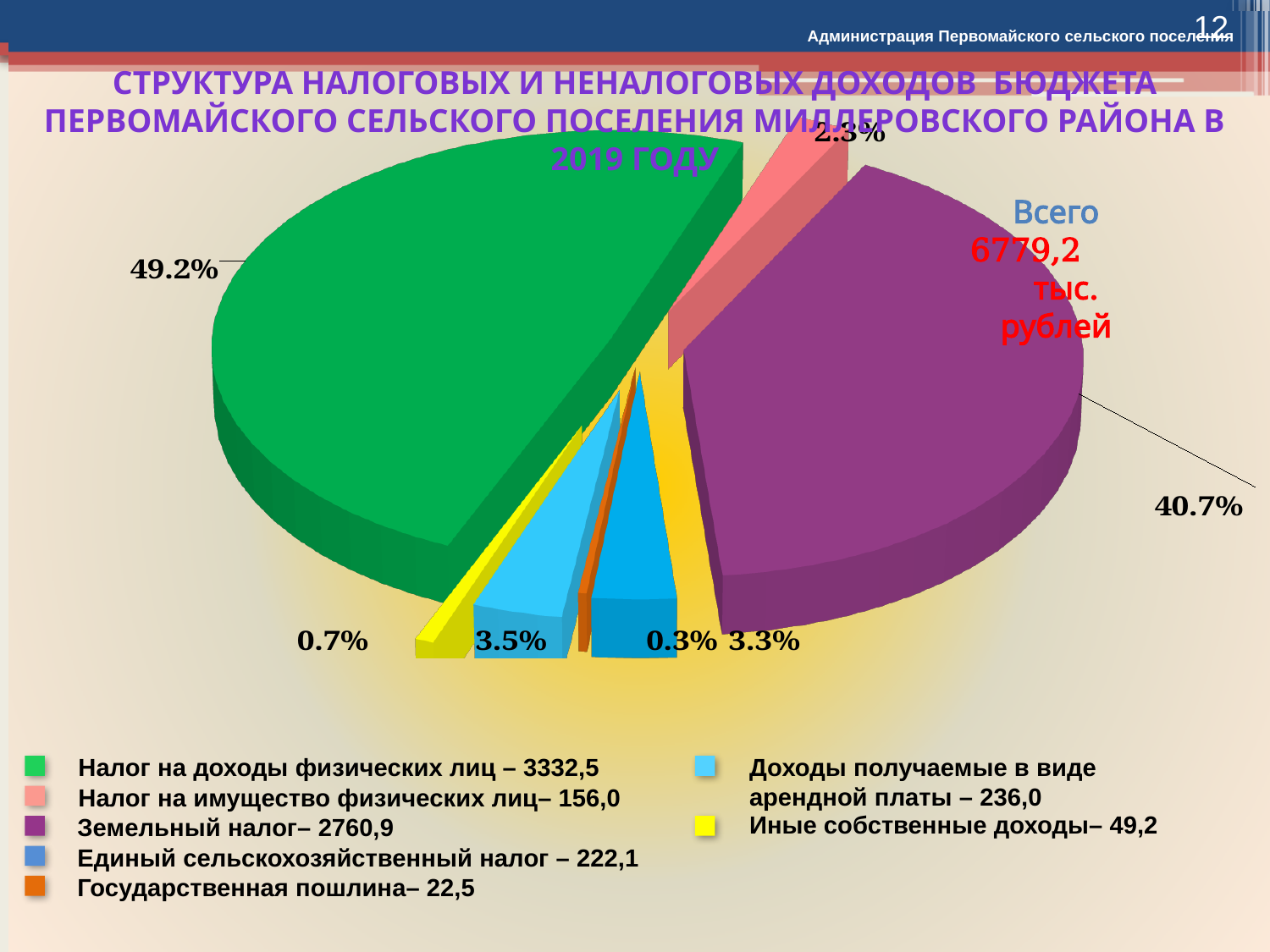
What share of the pie does Земельный налог have? 40.7% What is the difference between the legend values for Налог на доходы физических лиц (3332,5) and Земельный налог (2760,9)? 571,6 What is the difference in percentage points between the share of Налог на доходы физических лиц (49.2%) and Земельный налог (40.7%)? 8.5% What value is given in the legend for Земельный налог? 2760,9 What total amount (Всего) is shown next to the pie chart? 6779,2 тыс. рублей What value is given in the legend for Иные собственные доходы? 49,2 What share of the pie does Налог на имущество физических лиц have? 2.3% Which category has the largest share of the pie? Налог на доходы физических лиц Which category has the smallest share of the pie? Государственная пошлина Which has the larger share: Доходы получаемые в виде арендной платы or Единый сельскохозяйственный налог? Доходы получаемые в виде арендной платы How many categories does the legend of the pie chart list? 7 What kind of chart is shown on the slide? pie chart